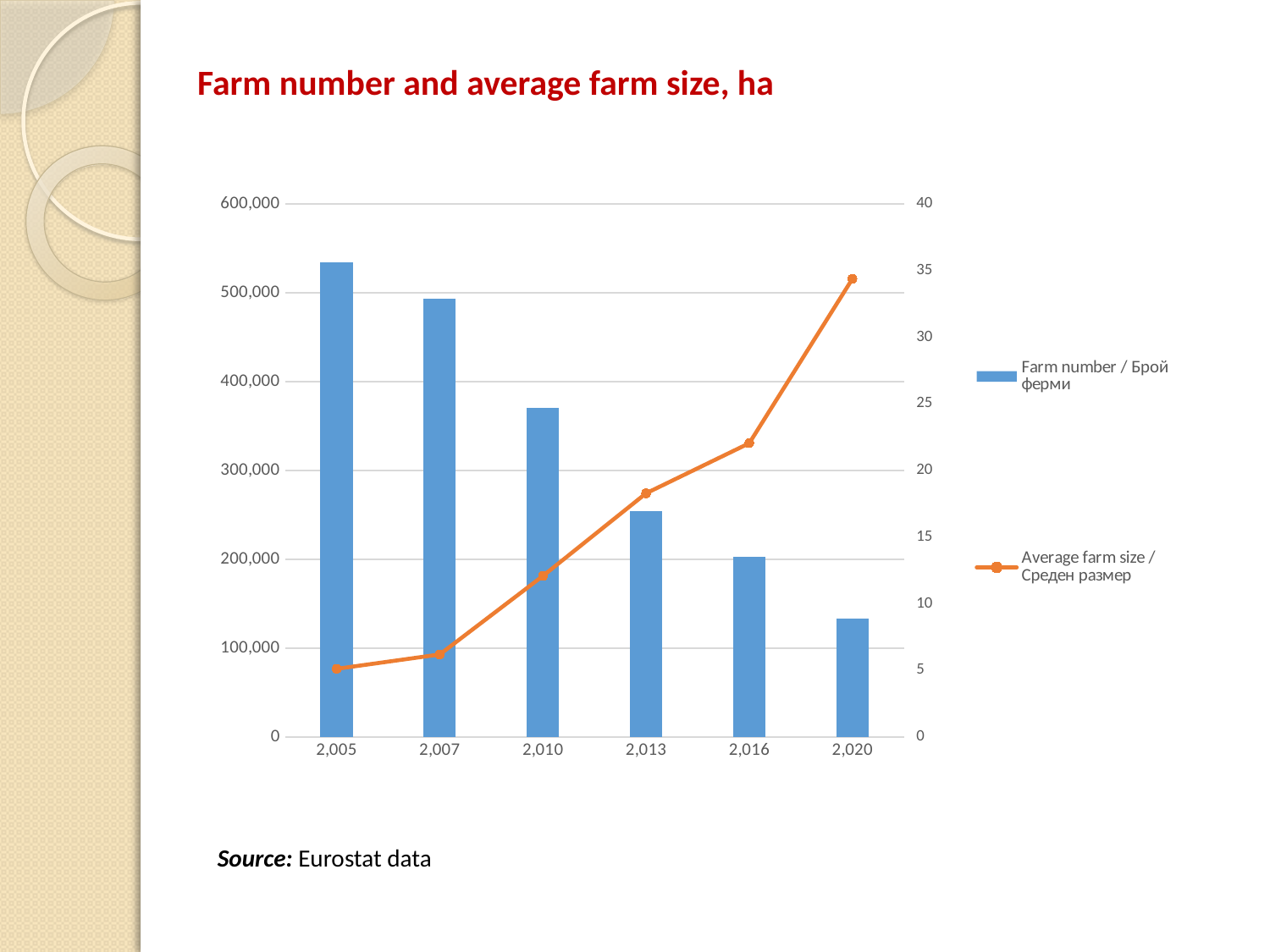
What kind of chart is shown on the slide? A combined bar and line chart Which year has the lowest farm number? 2,020 Is the farm number for 2,010 greater or less than 400,000? less Which year has the highest farm number? 2,005 Does the farm number rise or fall from 2,005 to 2,020? Fall Which year has the highest average farm size? 2,020 How many series does the legend list? 2 How many years are shown on the x axis? 6 Which series is drawn as a line in the chart? Average farm size / Среден размер Is the average farm size for 2,020 greater or less than 30? greater Is the farm number for 2,005 greater or less than 500,000? greater Does the average farm size rise or fall from 2,005 to 2,020? Rise